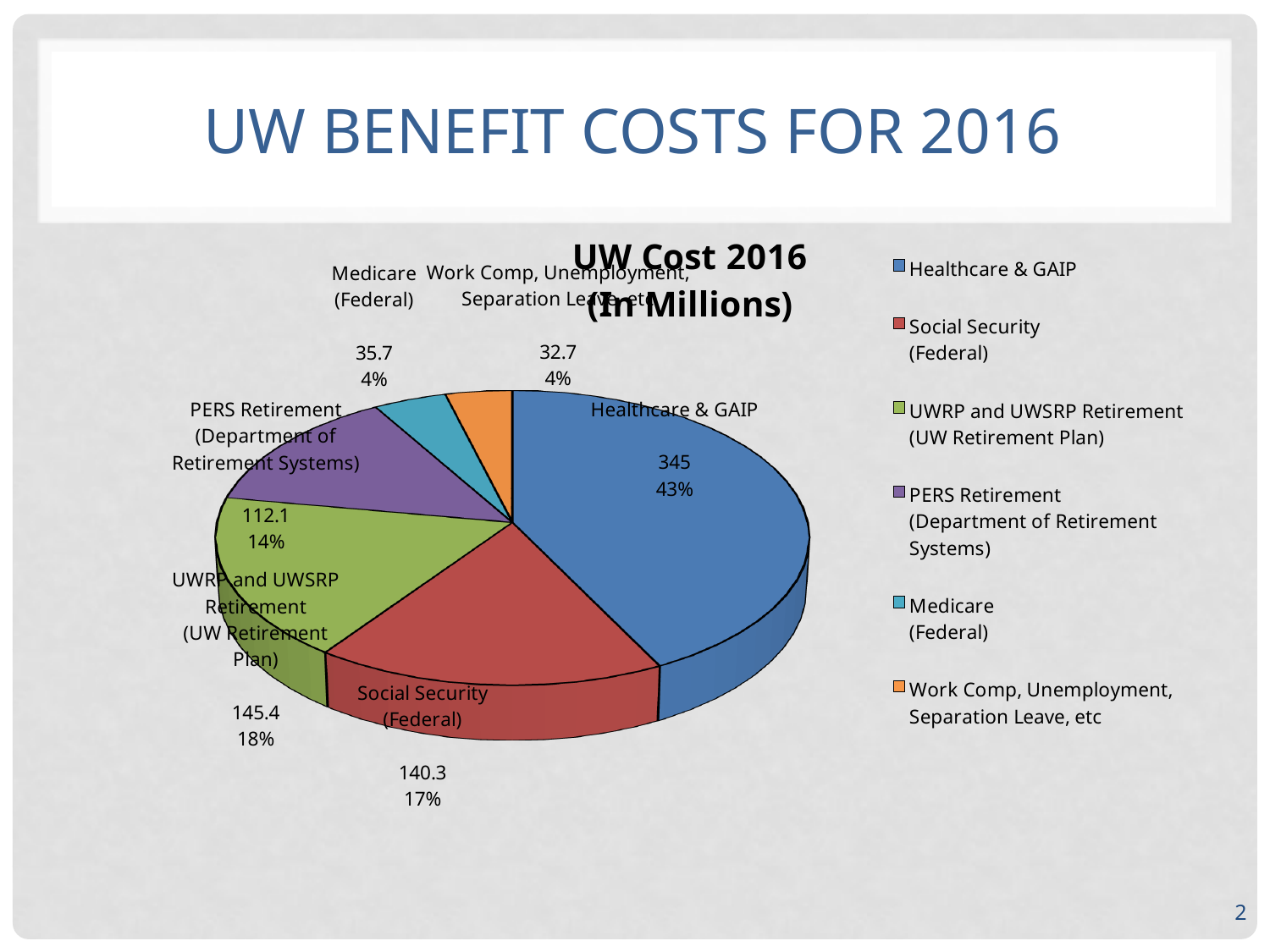
What is the value for Healthcare & GAIP? 345 What is the value for Social Security (Federal)? 140.3 What is the value for UWRP and UWSRP Retirement (UW Retirement Plan)? 145.4 What is the difference between the values for Medicare (Federal) and Work Comp, Unemployment, Separation Leave, etc? 3.0 Which is larger, the value for UWRP and UWSRP Retirement or the value for Social Security (Federal)? UWRP and UWSRP Retirement Which category has the largest slice of the pie? Healthcare & GAIP What share of the pie does UWRP and UWSRP Retirement (UW Retirement Plan) represent? 18% What is the value for Medicare (Federal)? 35.7 How many categories does the legend list? 6 What share of the pie does Healthcare & GAIP represent? 43% What kind of chart is shown on the slide? pie chart What is the value for PERS Retirement (Department of Retirement Systems)? 112.1